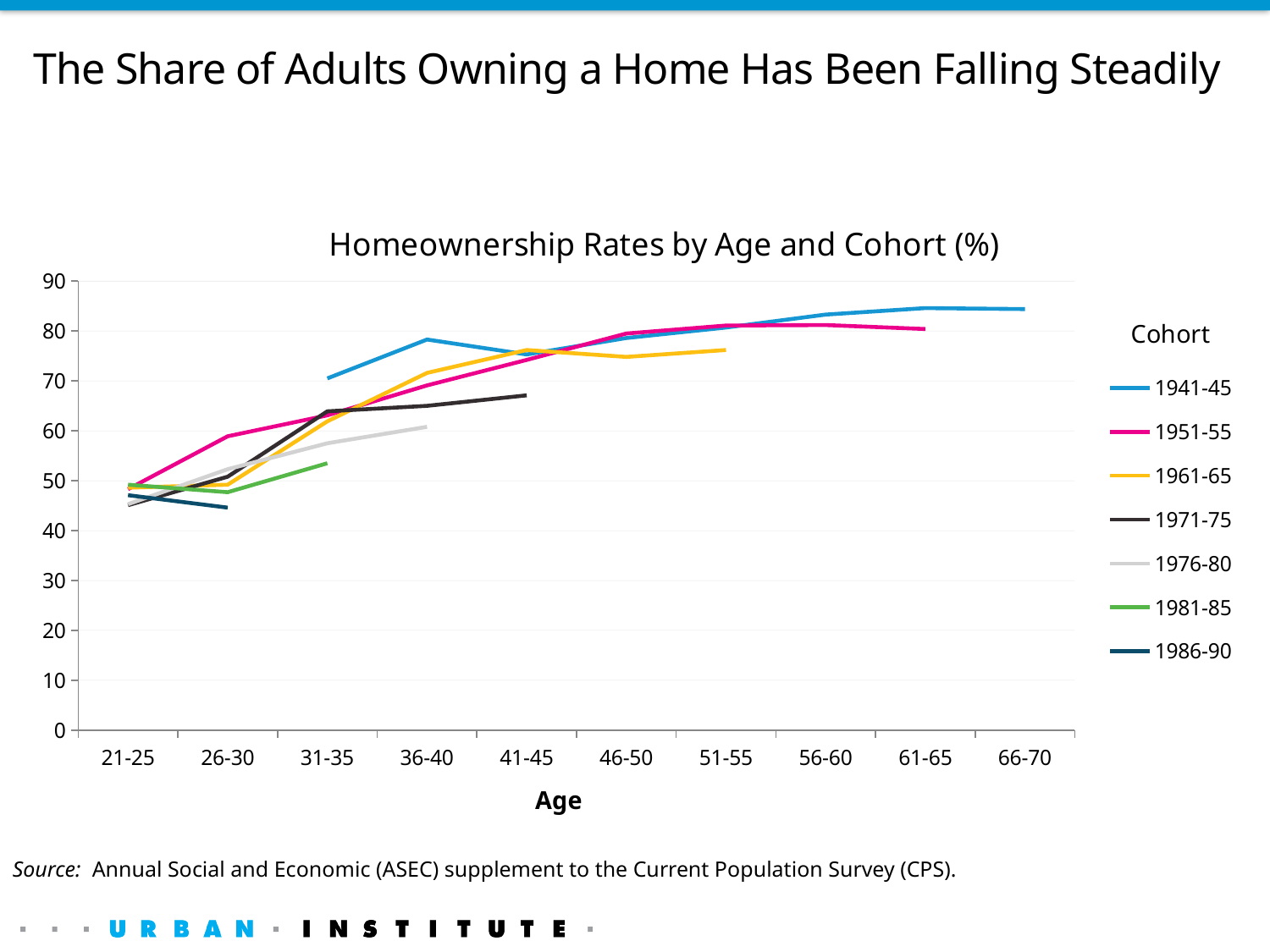
What is the label of the x axis? Age Is the homeownership rate for the 1986-90 cohort at age 26-30 greater or less than 50? less Is the homeownership rate for the 1951-55 cohort at age 26-30 greater or less than 50? greater How many cohorts does the legend list? 7 What kind of chart is shown on the slide? line chart What is the title of the chart? Homeownership Rates by Age and Cohort (%) Is the homeownership rate for the 1961-65 cohort at age 51-55 greater or less than 70? greater At age 36-40, which cohort has the higher homeownership rate, 1941-45 or 1951-55? 1941-45 Which cohort reaches the highest homeownership rate shown on the chart? 1941-45 How many age groups are shown on the x axis? 10 Does the homeownership rate for the 1941-45 cohort generally rise or fall as age increases? rise